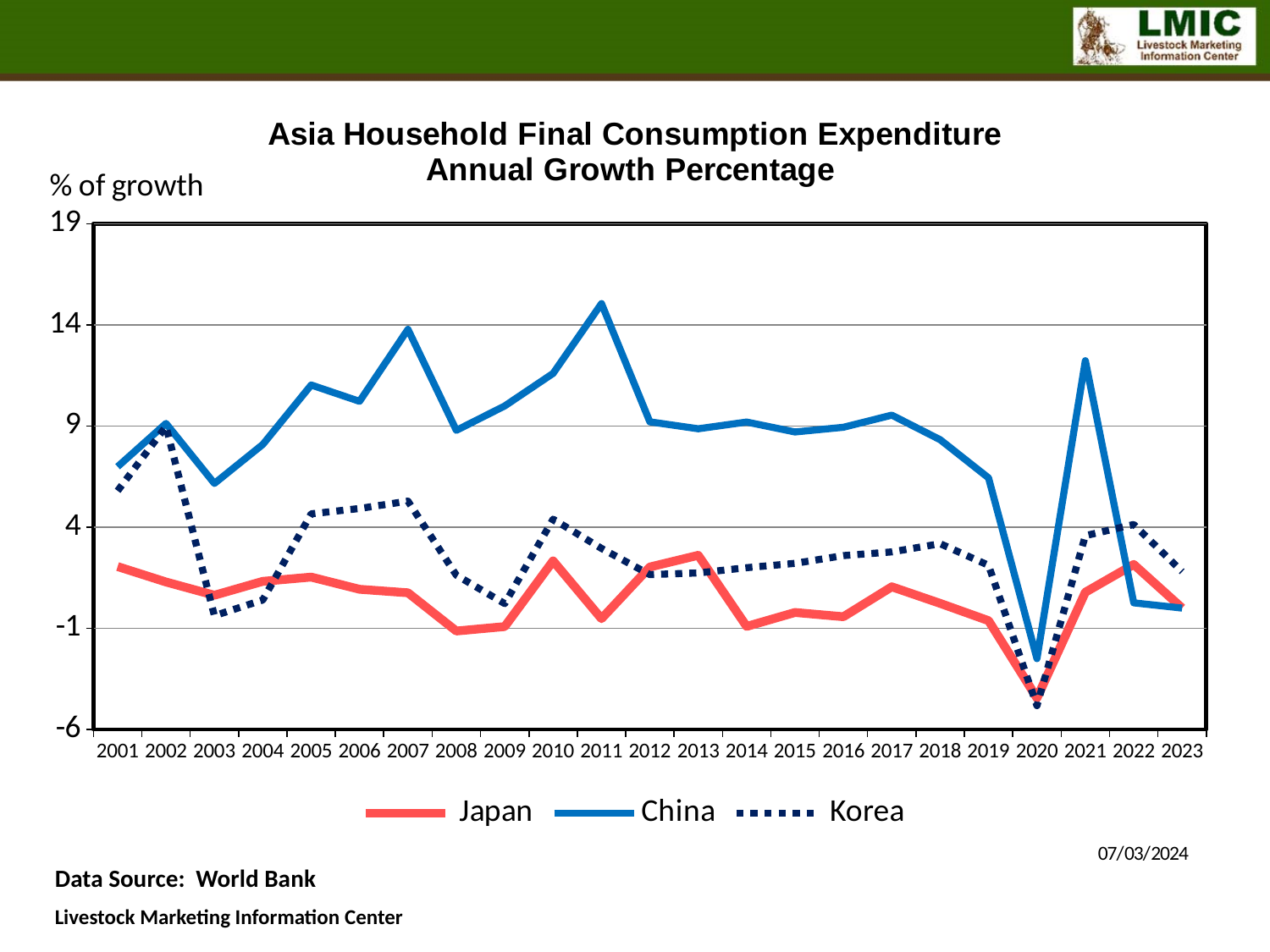
In which year does the China series reach its lowest value? 2020 In which year does the China series reach its highest value? 2011 How many years are plotted along the x axis? 23 Does the China series rise or fall from 2017 to 2020? fall What kind of chart is shown on the slide? line chart In which year does the Korea series reach its lowest value? 2020 How many series does the legend list? 3 Is the value for China in 2011 greater or less than 14? greater Which series has the larger value in 2007, Korea or Japan? Korea What is the data source named on the slide? World Bank Is the value for Japan in 2020 greater or less than -1? less Is the value for China in 2021 greater or less than 9? greater